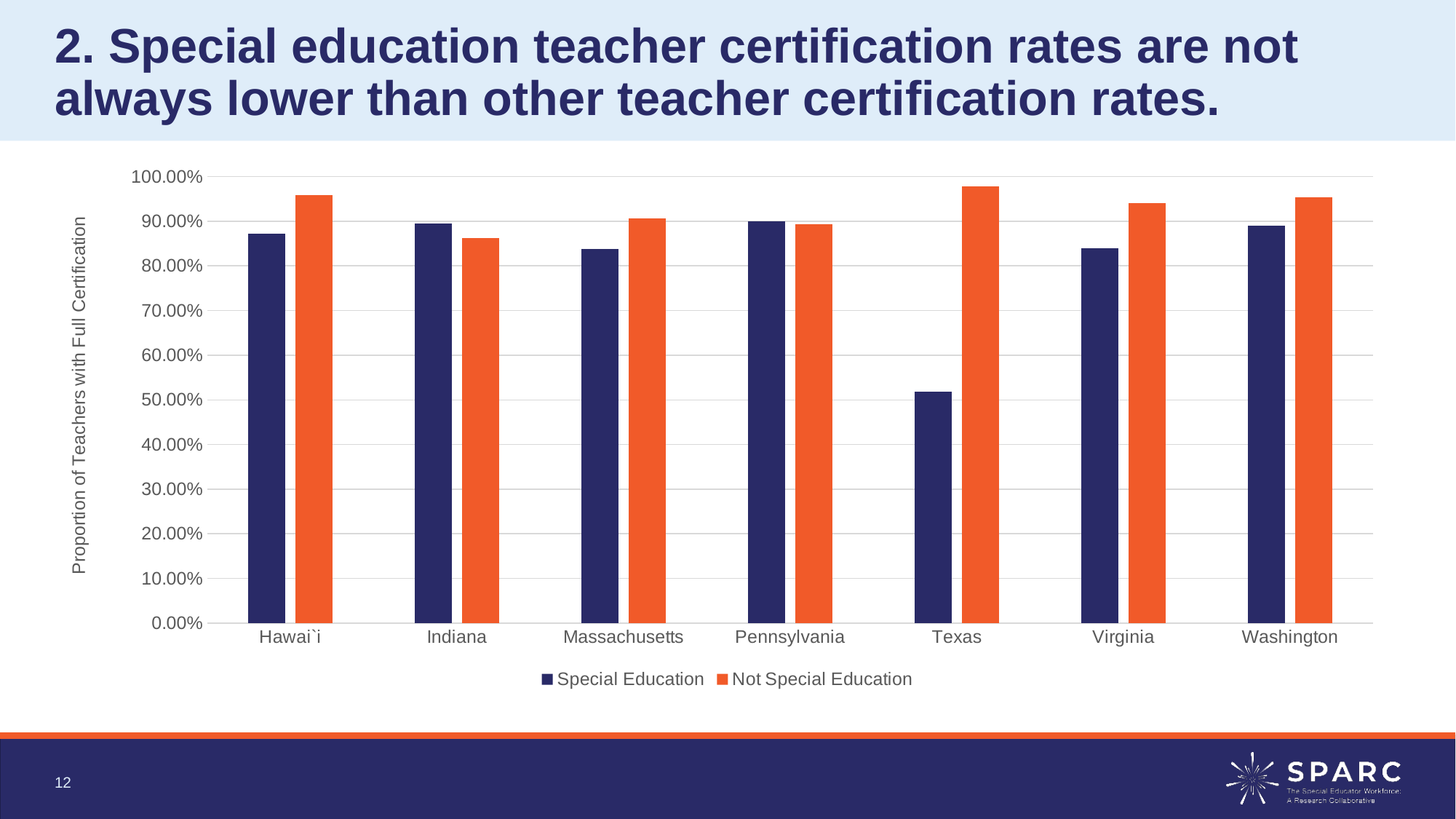
How many series does the chart's legend list? 2 How many states are shown on the x axis of the chart? 7 Which state has the highest Not Special Education certification rate? Texas Which state has the lowest Special Education certification rate? Texas In Indiana, which is larger: the Special Education rate or the Not Special Education rate? Special Education What is the label on the chart's vertical axis? Proportion of Teachers with Full Certification What kind of chart is shown on the slide? Bar chart In Texas, which is larger: the Special Education rate or the Not Special Education rate? Not Special Education In Virginia, which is larger: the Special Education rate or the Not Special Education rate? Not Special Education Is the Not Special Education value for Hawai`i greater or less than 90.00%? greater Is the Special Education value for Texas greater or less than 60.00%? less Is the Special Education value for Massachusetts greater or less than 90.00%? less